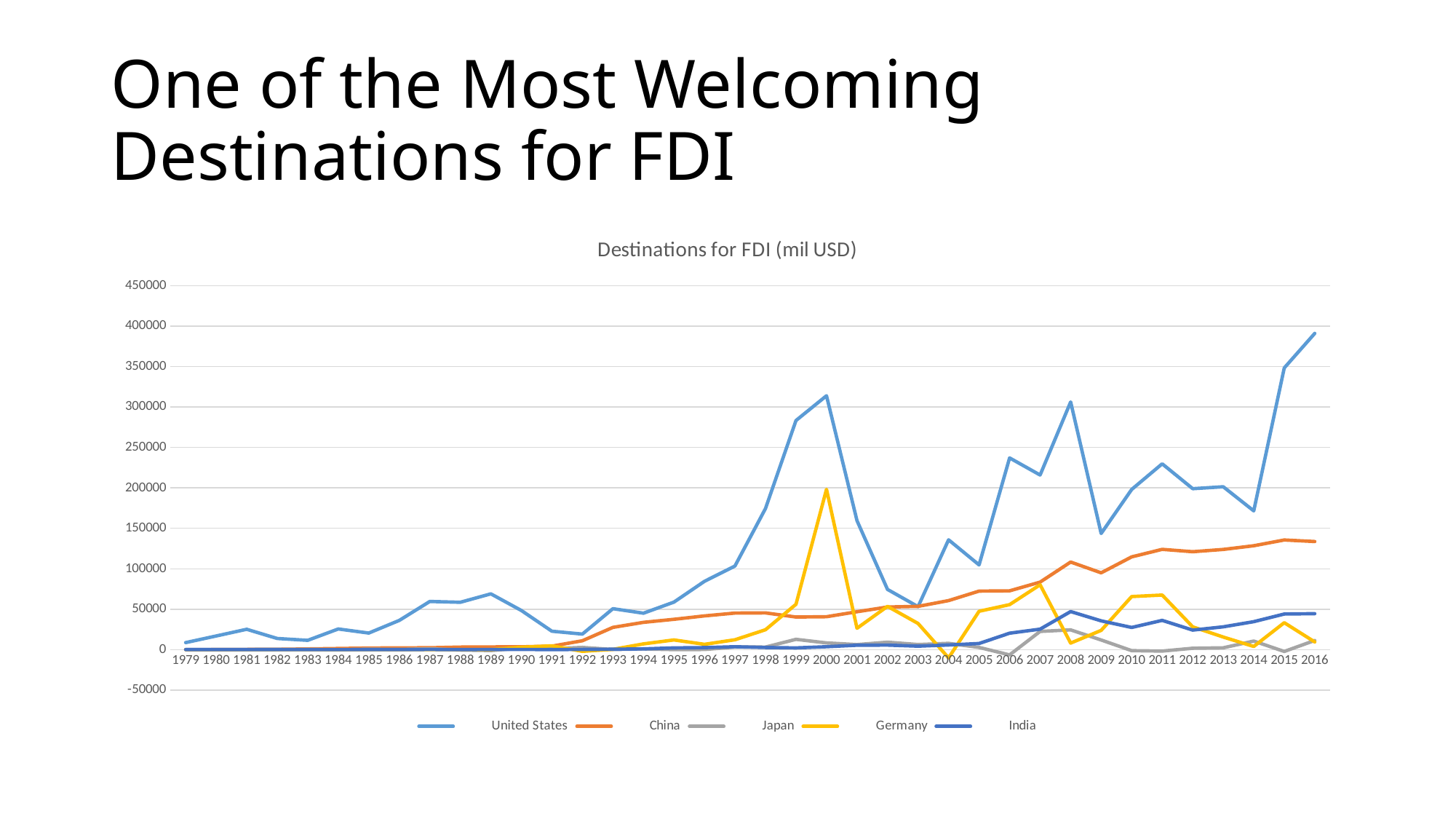
Is the value for China in 2016 greater or less than 100000? greater How many years are plotted along the x axis of the chart? 38 Is the value for Germany in 2000 greater or less than 150000? greater How many series does the legend of the chart list? 5 Is the value for United States in 2000 greater or less than 250000? greater What is the title of the chart? Destinations for FDI (mil USD) Which series reaches the highest value anywhere on the chart? United States What kind of chart is shown on the slide? line chart In 2008, which is larger: the value for United States or the value for China? United States Do the values for China generally rise or fall from 2003 to 2016? rise